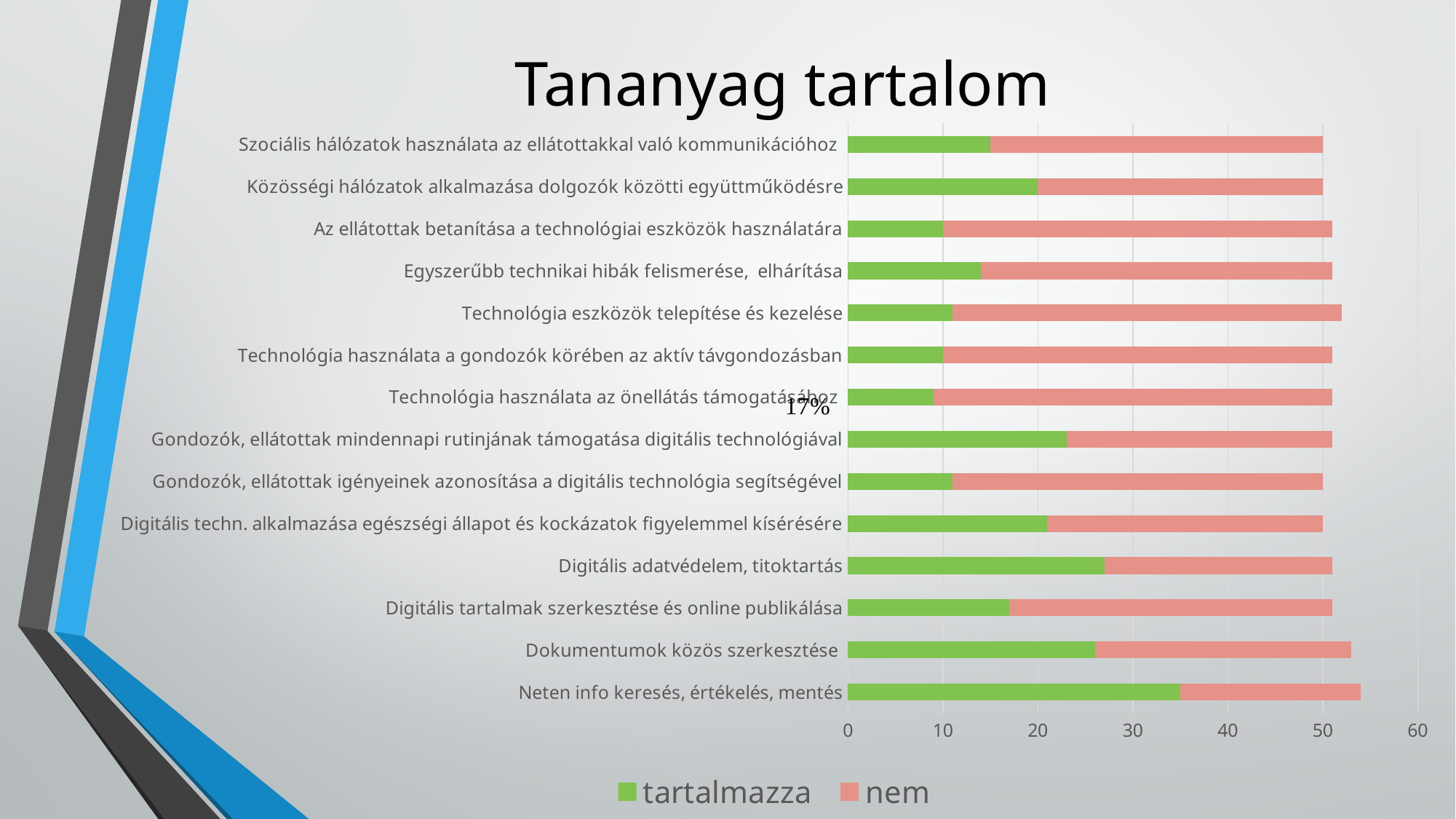
Which colour represents the 'nem' series in the chart? red Which has the larger 'tartalmazza' value: 'Neten info keresés, értékelés, mentés' or 'Digitális tartalmak szerkesztése és online publikálása'? Neten info keresés, értékelés, mentés Which category has the highest 'tartalmazza' value? Neten info keresés, értékelés, mentés What kind of chart is shown on the slide? bar chart What is the title of the chart? Tananyag tartalom Is the 'tartalmazza' value for 'Az ellátottak betanítása a technológiai eszközök használatára' greater or less than 20? less How many series does the legend list? 2 Is the 'tartalmazza' value for 'Neten info keresés, értékelés, mentés' greater or less than 30? greater Is the 'tartalmazza' value for 'Digitális adatvédelem, titoktartás' greater or less than 20? greater How many categories are plotted on the chart? 14 Which has the larger 'tartalmazza' value: 'Dokumentumok közös szerkesztése' or 'Technológia használata az önellátás támogatásához'? Dokumentumok közös szerkesztése